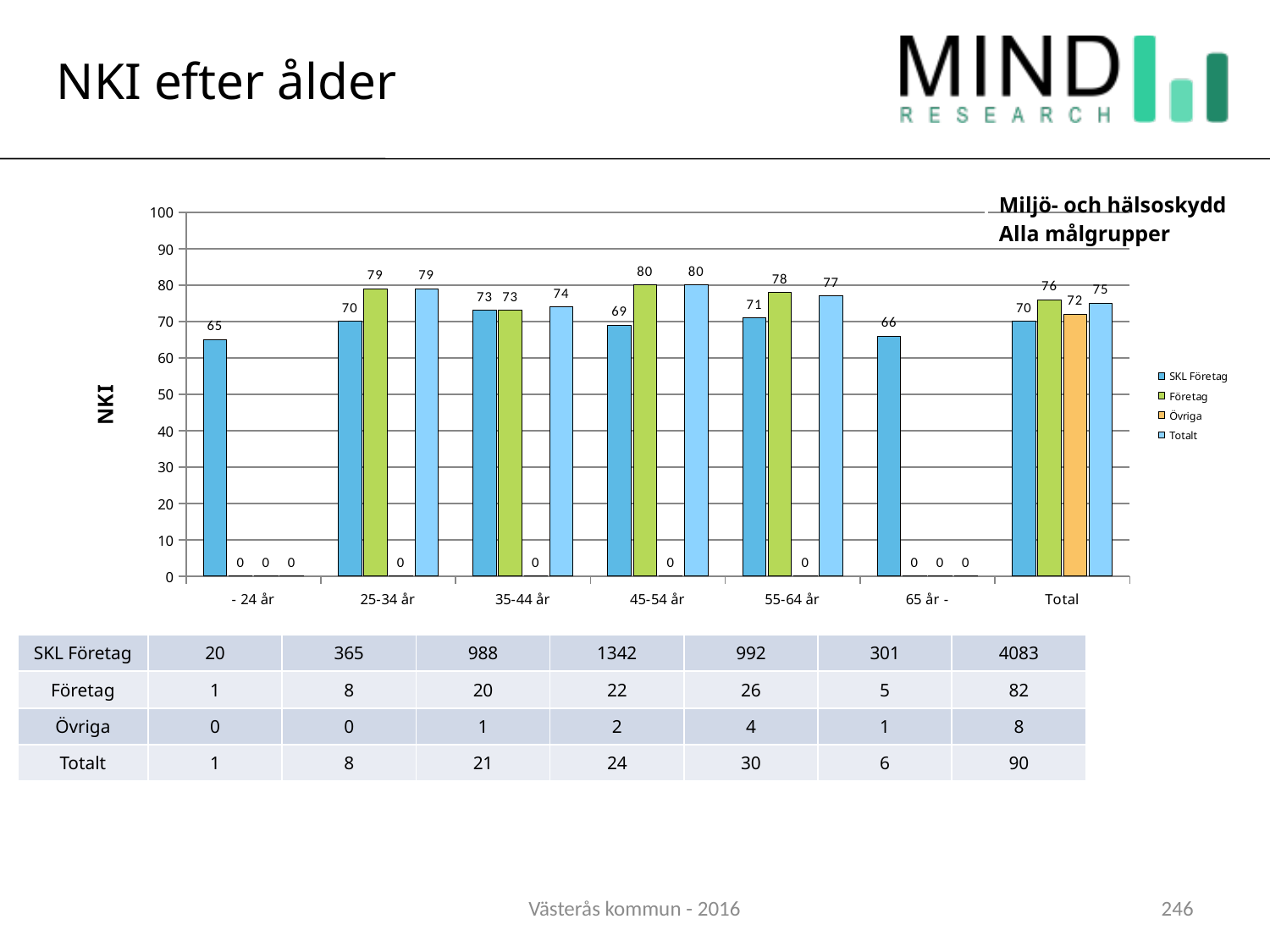
What is the difference between the Företag value and the SKL Företag value for '45-54 år'? 11 What is the Totalt value for the '55-64 år' category? 77 For the '25-34 år' category, which is larger: the SKL Företag value or the Företag value? Företag What is the SKL Företag value for the '- 24 år' category? 65 Which age category has the highest SKL Företag value? 35-44 år How many age categories (including Total) are shown on the x axis of the chart? 7 What is the Övriga value for the 'Total' category? 72 What is the label of the y axis of the chart? NKI What kind of chart is shown on the slide? bar chart How many series does the chart legend list? 4 Which age category has the lowest SKL Företag value? - 24 år What is the Företag value for the '45-54 år' category? 80